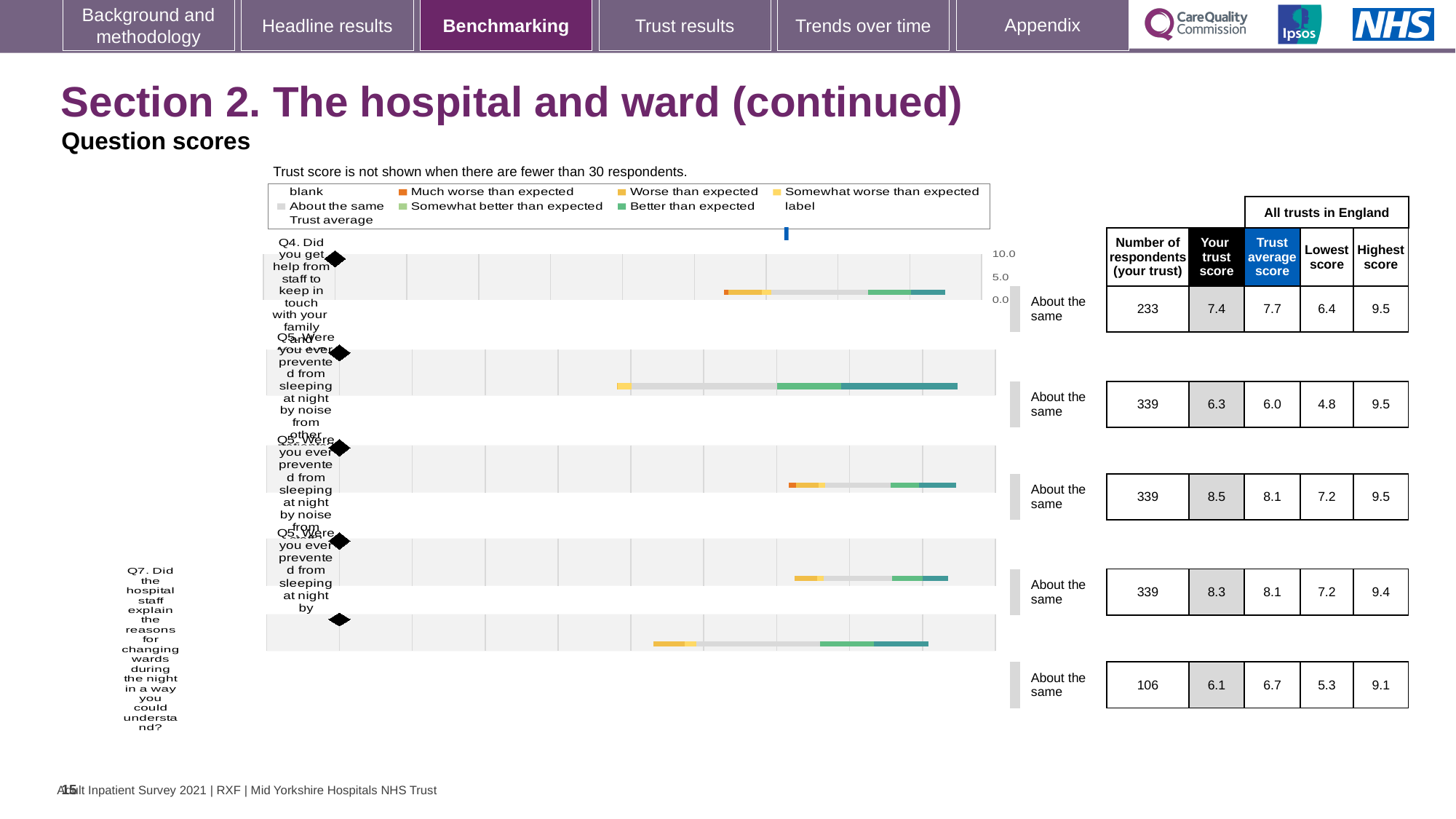
Which question has the lowest number of respondents in the table? Q7 What is the highest 'Your trust score' shown in the table on this slide? 8.5 How many respondents from your trust answered Q4? 233 What is the lowest score across all trusts in England for Q7? 5.3 For Q4, what is the difference between the trust average score (7.7) and your trust score (7.4)? 0.3 What benchmark category label is shown next to the Q4 bar? About the same What is the 'Your trust score' for Q4 (help from staff to keep in touch with family)? 7.4 How many question rows (bars) are shown on this slide? 5 What kind of chart is used to show the question scores on this slide? bar chart What is the trust average score for Q7 (explaining reasons for changing wards during the night)? 6.7 For Q5 (prevented from sleeping by noise from other patients), which is larger: your trust score or the trust average score? Your trust score